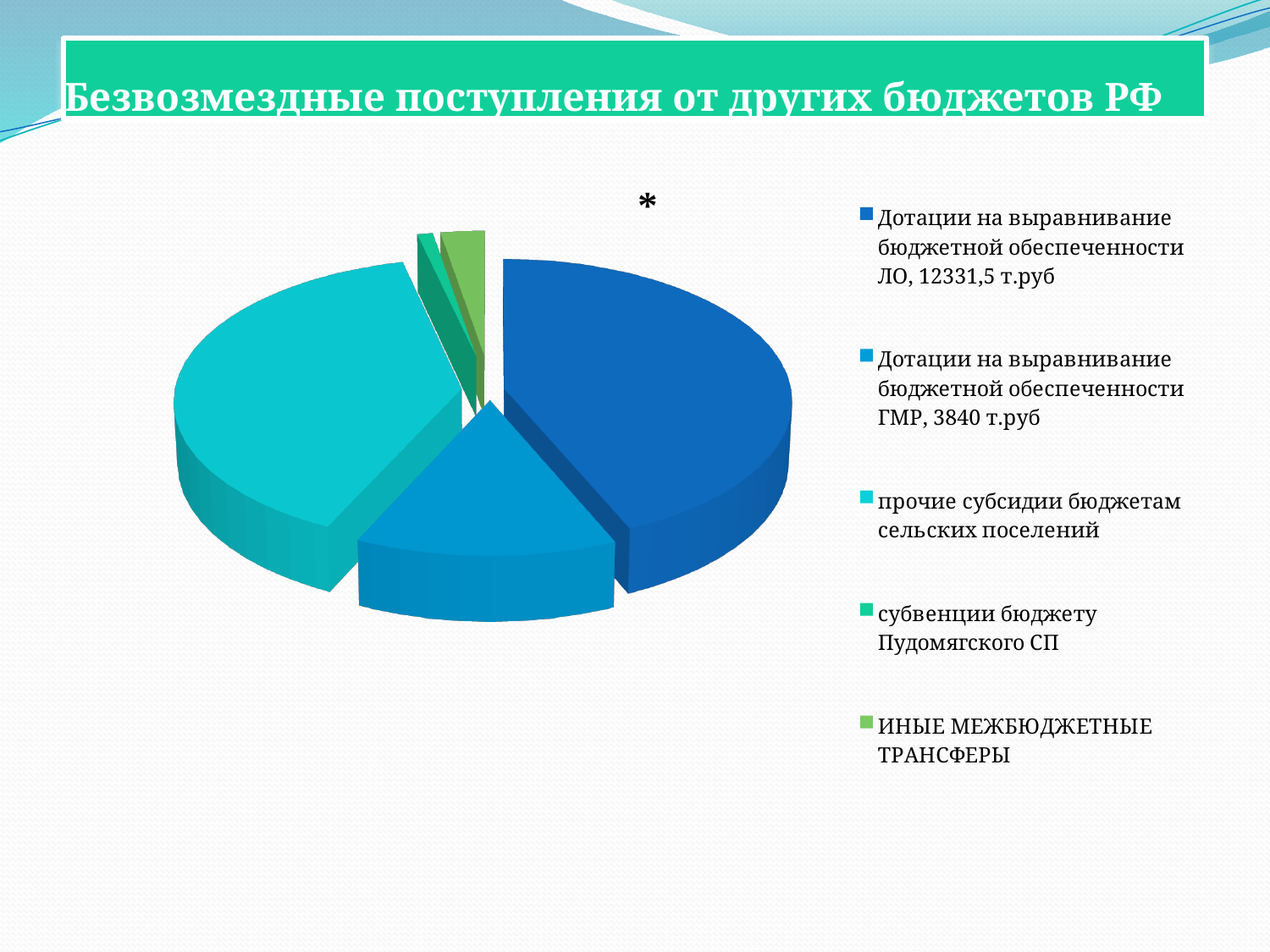
Which category has the largest slice of the pie chart? Дотации на выравнивание бюджетной обеспеченности ЛО Which is larger: the value for "Дотации на выравнивание бюджетной обеспеченности ЛО" or for "Дотации на выравнивание бюджетной обеспеченности ГМР"? Дотации на выравнивание бюджетной обеспеченности ЛО What is the title of the slide? Безвозмездные поступления от других бюджетов РФ What kind of chart is shown on the slide? pie chart Which legend entry is shown in light green? ИНЫЕ МЕЖБЮДЖЕТНЫЕ ТРАНСФЕРЫ What value is given in the legend for "Дотации на выравнивание бюджетной обеспеченности ГМР"? 3840 т.руб What is the difference between the values for "Дотации на выравнивание бюджетной обеспеченности ЛО" and "Дотации на выравнивание бюджетной обеспеченности ГМР"? 8491,5 т.руб How many entries does the legend of the pie chart list? 5 What value is given in the legend for "Дотации на выравнивание бюджетной обеспеченности ЛО"? 12331,5 т.руб How many slices does the pie chart have? 5